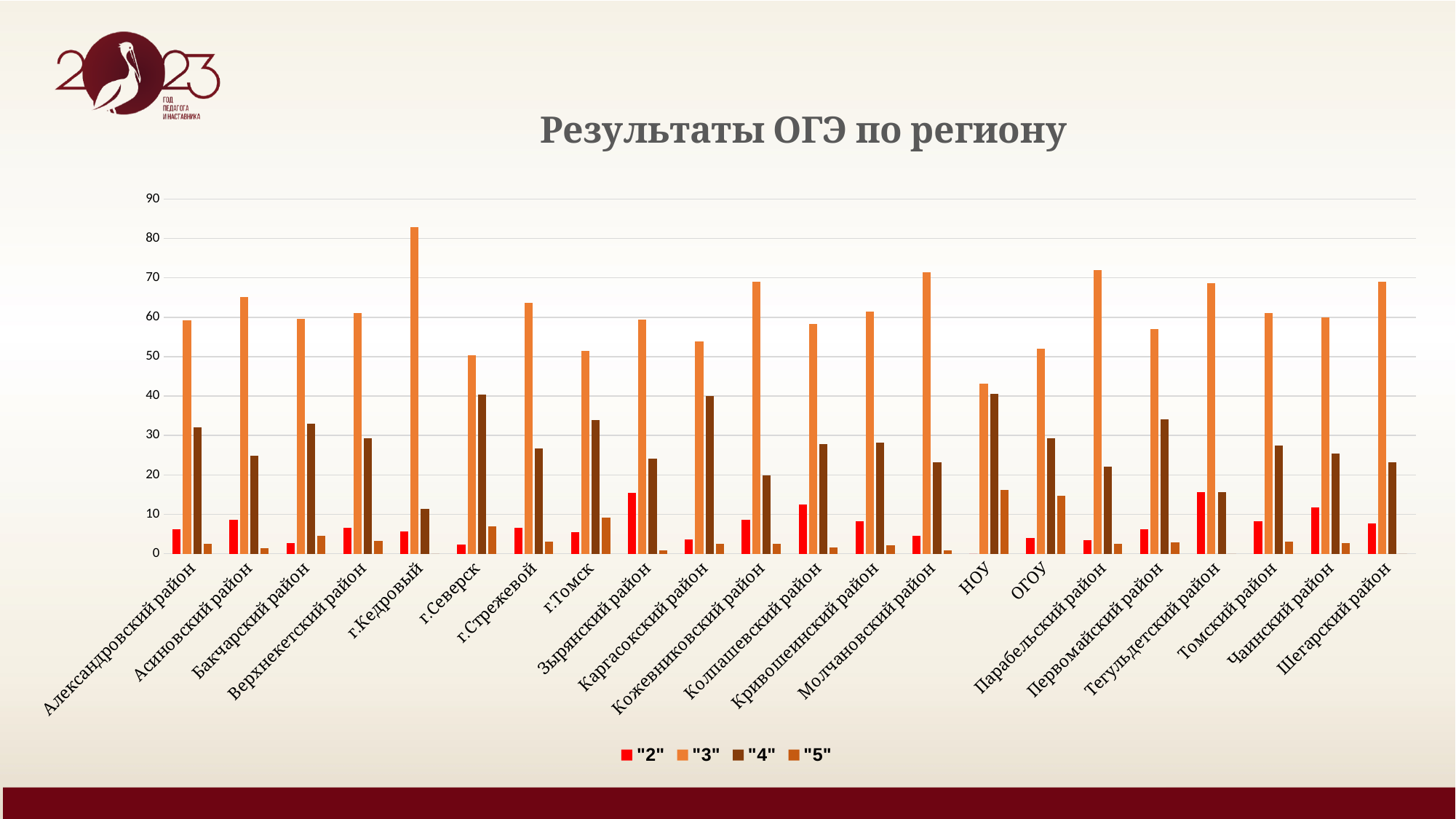
Is the value of the "3" series for г.Кедровый greater or less than 80? greater How many series does the legend list? 4 Is the value of the "4" series for Александровский район greater or less than 30? greater How many categories are shown along the x axis? 22 Which category has the highest value for the "3" series? г.Кедровый For г.Северск and Асиновский район, which has the larger value in the "4" series? г.Северск Is the value of the "2" series for Зырянский район greater or less than 10? greater Which category has the lowest value for the "3" series? НОУ What kind of chart is shown on the slide? Bar chart What is the title of the chart? Результаты ОГЭ по региону Which colour represents the "2" series in the legend? Red